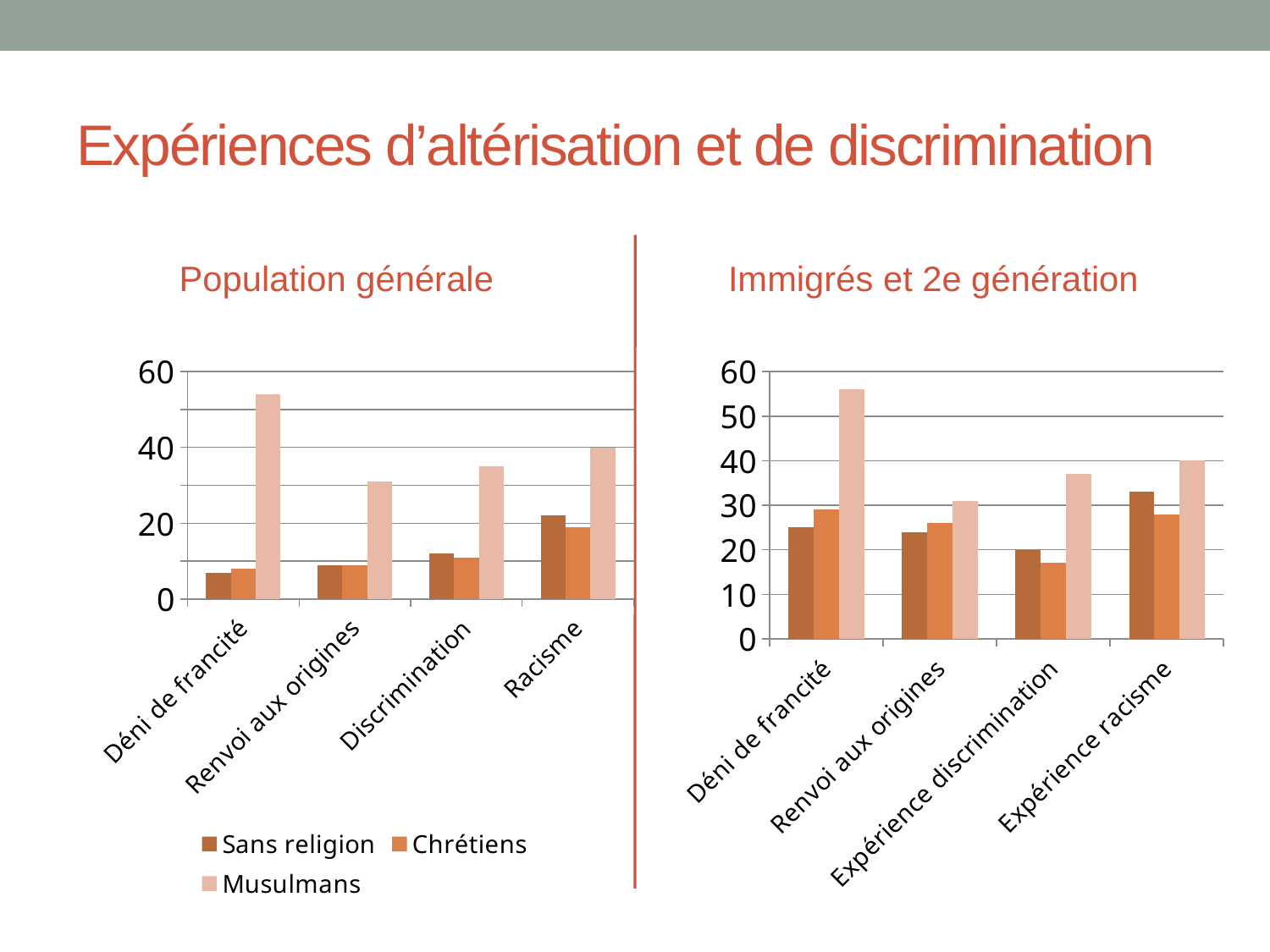
In the 'Population générale' chart, is the Musulmans value for 'Déni de francité' greater or less than 40? greater What is the title of the chart on the right side of the slide? Immigrés et 2e génération In the 'Immigrés et 2e génération' chart, which category has the lowest Chrétiens bar? Expérience discrimination What kind of chart is the 'Population générale' chart? bar chart In the 'Immigrés et 2e génération' chart, is the Chrétiens value for 'Expérience discrimination' greater or less than 20? less How many categories are shown on the x axis of the 'Immigrés et 2e génération' chart? 4 How many series does the legend of the 'Population générale' chart list? 3 In the 'Immigrés et 2e génération' chart, for 'Déni de francité', which is larger: Sans religion or Chrétiens? Chrétiens In the 'Population générale' chart, which series has the highest bar for 'Déni de francité'? Musulmans In the 'Immigrés et 2e génération' chart, which category has the highest Musulmans bar? Déni de francité In the 'Immigrés et 2e génération' chart, is the Musulmans value for 'Déni de francité' greater or less than 50? greater In the 'Population générale' chart, for 'Racisme', which is larger: Sans religion or Chrétiens? Sans religion